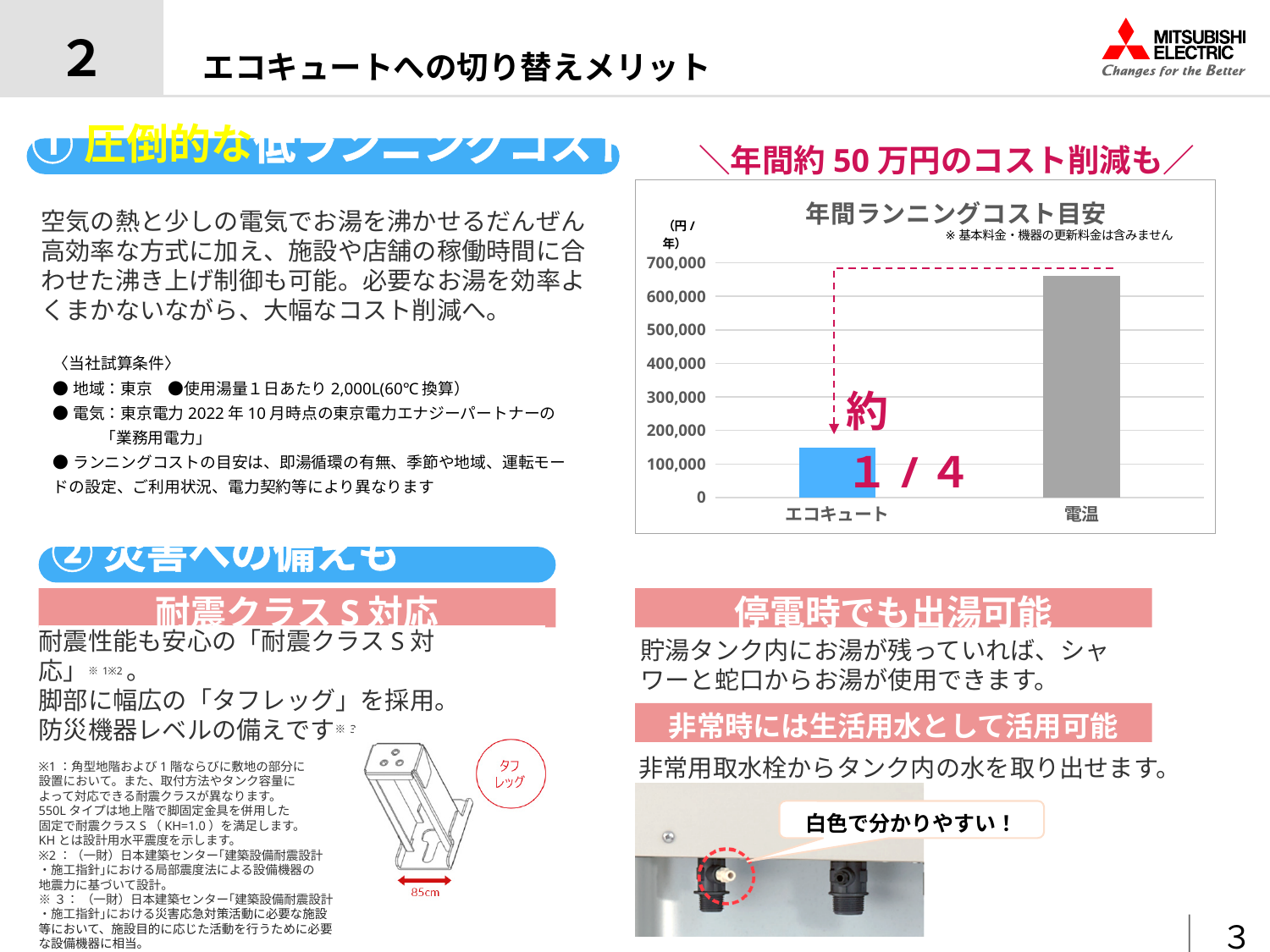
What unit is shown on the vertical axis of the 年間ランニングコスト目安 chart? 円/年 What kind of chart is shown under the title 年間ランニングコスト目安? bar chart Which category has the lowest value in the 年間ランニングコスト目安 chart? エコキュート In the 年間ランニングコスト目安 chart, is the value for 電温 greater or less than 600,000? greater Which category has the highest value in the 年間ランニングコスト目安 chart? 電温 In the 年間ランニングコスト目安 chart, is the value for エコキュート greater or less than 200,000? less What is the title of the chart on the slide? 年間ランニングコスト目安 How many categories are plotted in the 年間ランニングコスト目安 chart? 2 Do the values in the 年間ランニングコスト目安 chart rise or fall from left to right along the x axis? rise In the 年間ランニングコスト目安 chart, which is larger, the value for エコキュート or the value for 電温? 電温 In the 年間ランニングコスト目安 chart, is the value for エコキュート greater or less than 100,000? greater